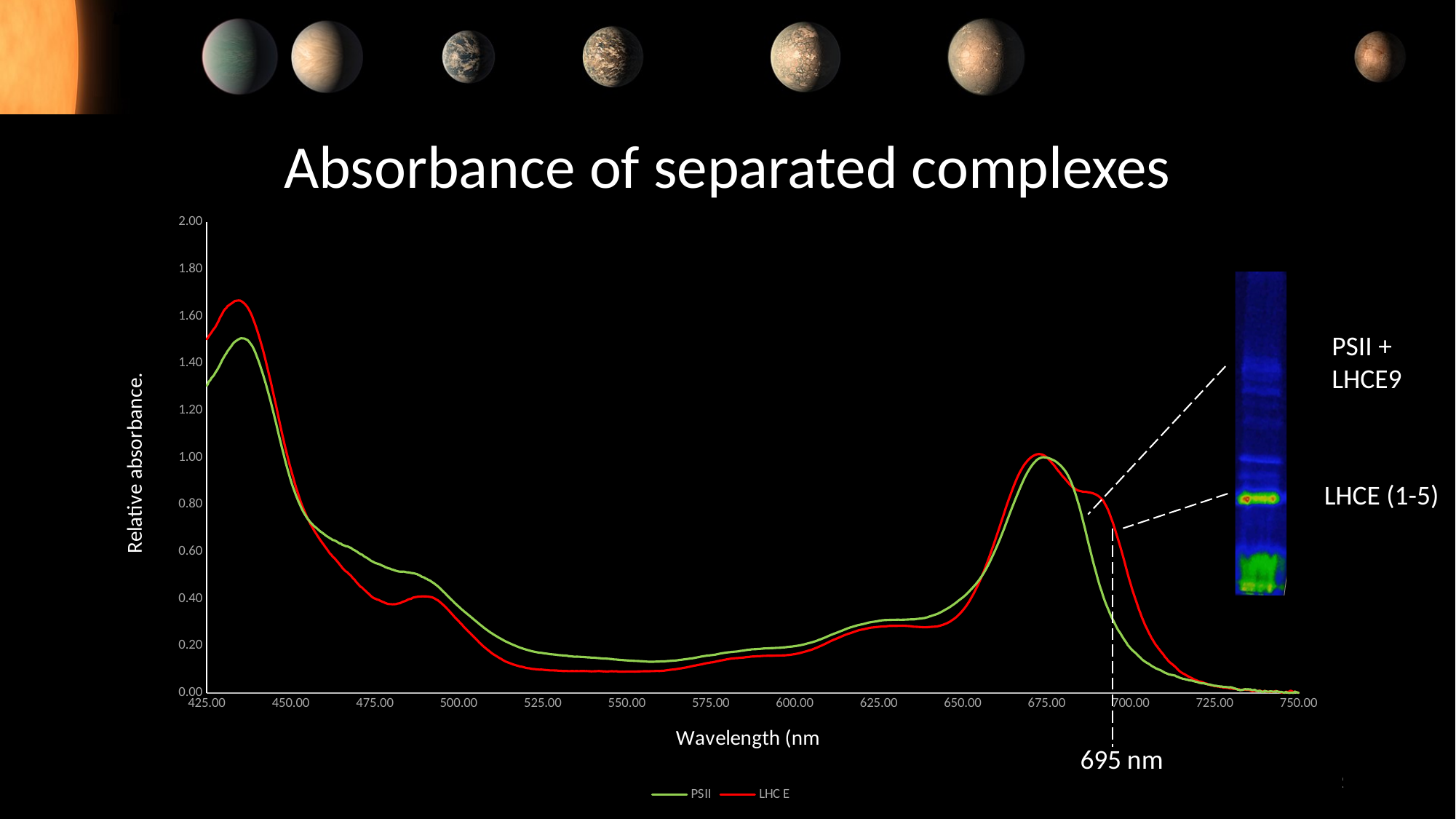
Is the peak relative absorbance of PSII near 435 nm greater or less than 1.20? greater At 475 nm, which series has the higher relative absorbance, PSII or LHC E? PSII What is the title of the chart on the slide? Absorbance of separated complexes What wavelength is marked by the vertical dashed line on the chart? 695 nm Between 450 nm and 525 nm, does the PSII relative absorbance rise or fall? fall At the peak near 435 nm, which series reaches the higher relative absorbance, PSII or LHC E? LHC E Is the relative absorbance of PSII at 550 nm greater or less than 0.40? less Is the relative absorbance of LHC E at 695 nm greater or less than 0.40? greater What type of chart is shown on the slide? Line chart How many series does the chart legend list? 2 At 695 nm, which series has the higher relative absorbance, PSII or LHC E? LHC E